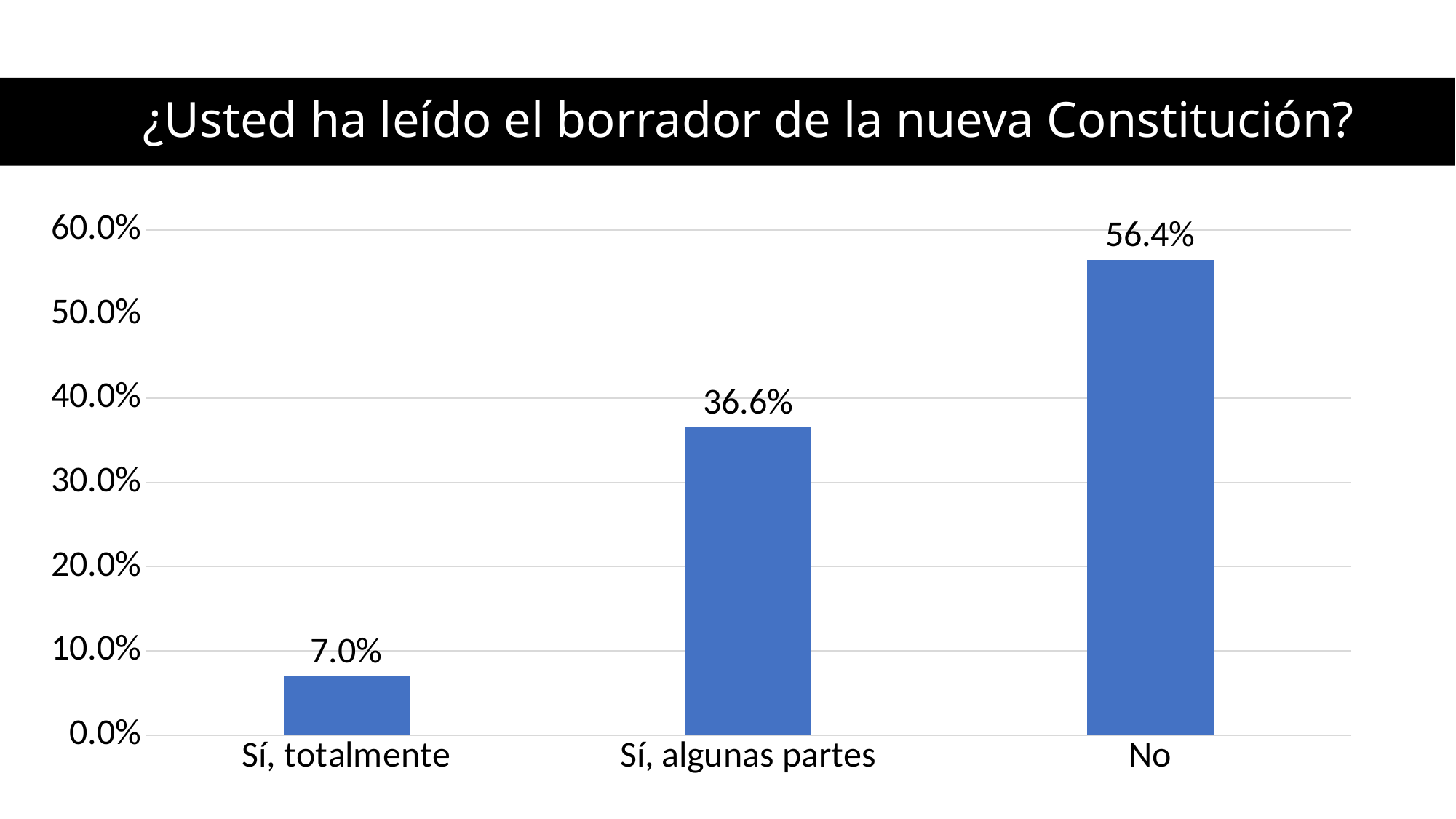
What is the value for "Sí, totalmente"? 7.0% What is the value for "No"? 56.4% What is the difference between the values for "Sí, algunas partes" and "Sí, totalmente"? 29.6% Which is larger, the value for "Sí, totalmente" or the value for "Sí, algunas partes"? Sí, algunas partes What is the difference between the values for "No" and "Sí, algunas partes"? 19.8% Is the value for "No" greater or less than 50.0%? greater How many categories are shown on the x axis? 3 Which category has the lowest value? Sí, totalmente Which category has the highest value? No What is the value for "Sí, algunas partes"? 36.6% What kind of chart is shown on the slide? bar chart What is the title of the chart? ¿Usted ha leído el borrador de la nueva Constitución?